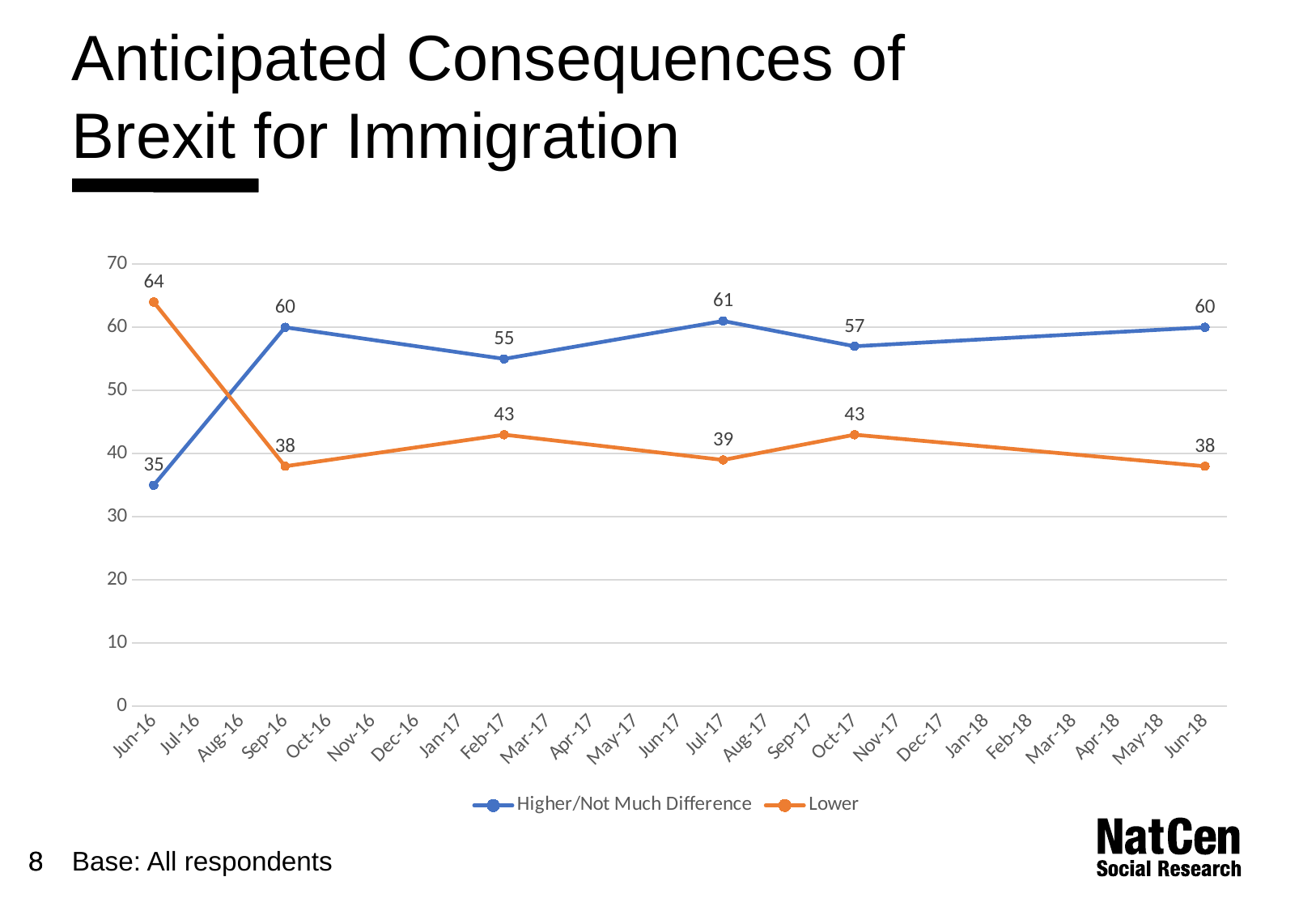
Is the value for Lower in Jul-17 greater or less than 40? less Which colour is used for the Lower series? Orange Which series has the larger value in Jun-16, Higher/Not Much Difference or Lower? Lower What kind of chart is shown on the slide? Line chart How many data points are plotted for the Lower series? 6 In which month does the Higher/Not Much Difference series reach its highest value? Jul-17 In which month is the Higher/Not Much Difference series at its lowest value? Jun-16 How many series does the legend list? 2 What is the difference between Higher/Not Much Difference and Lower in Jun-18? 22 What is the value for Higher/Not Much Difference in Feb-17? 55 What is the value for Lower in Jun-16? 64 What is the value for Lower in Oct-17? 43